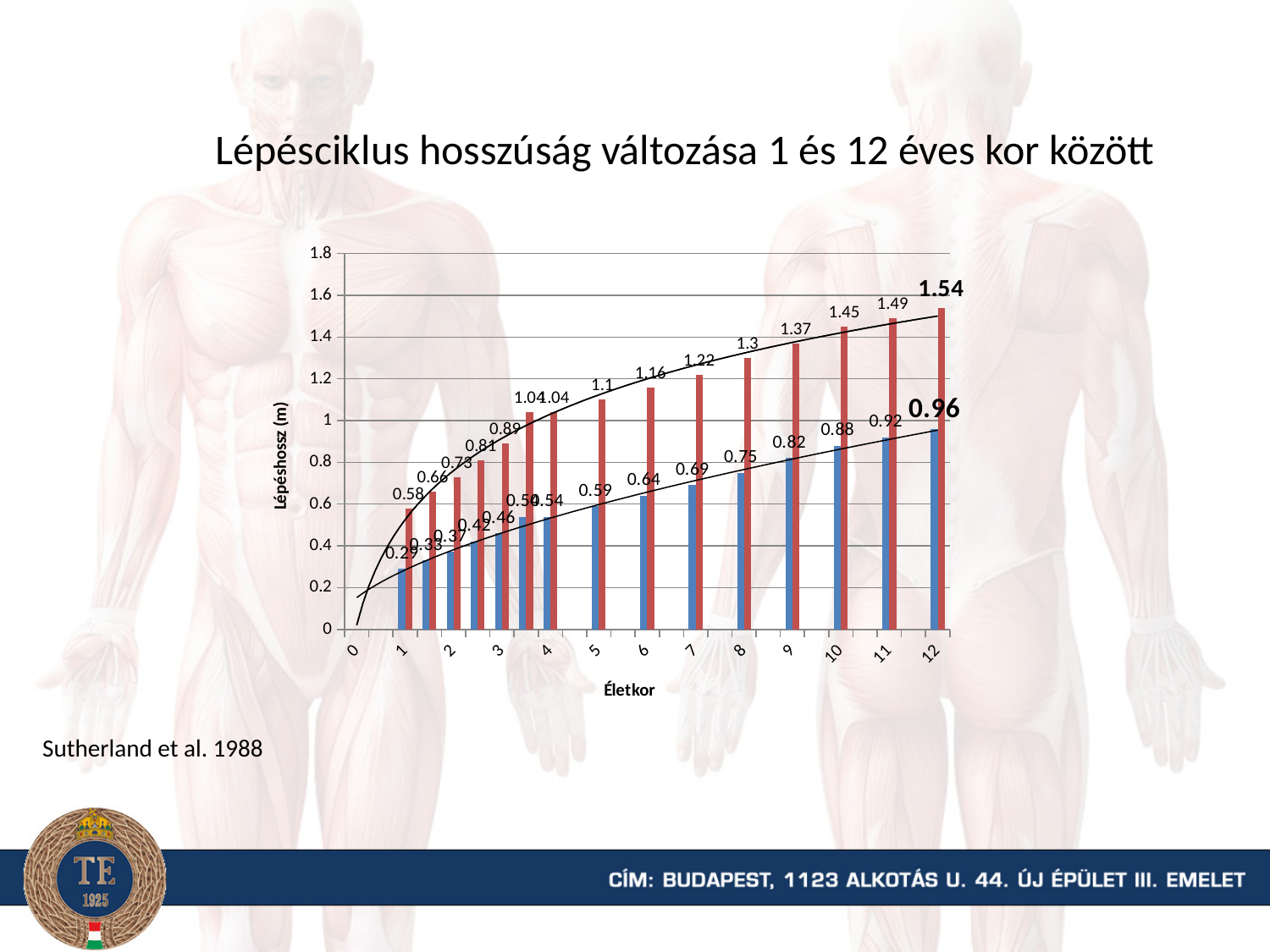
Do the blue bar values rise or fall as age increases along the x axis? rise Which is larger at age 6, the red bar or the blue bar? the red bar At which age is the blue bar lowest? 1 What is the value of the red bar at age (Életkor) 12? 1.54 What is the label of the vertical axis? Lépéshossz (m) What is the value of the blue bar at age (Életkor) 12? 0.96 What is the value of the red bar at age 1? 0.58 What kind of chart is shown on the slide? bar chart At which age is the red bar highest? 12 What is the difference between the red bar and the blue bar at age 10? 0.57 What is the value of the blue bar at age 8? 0.75 What is the difference between the red bar and the blue bar at age 12? 0.58